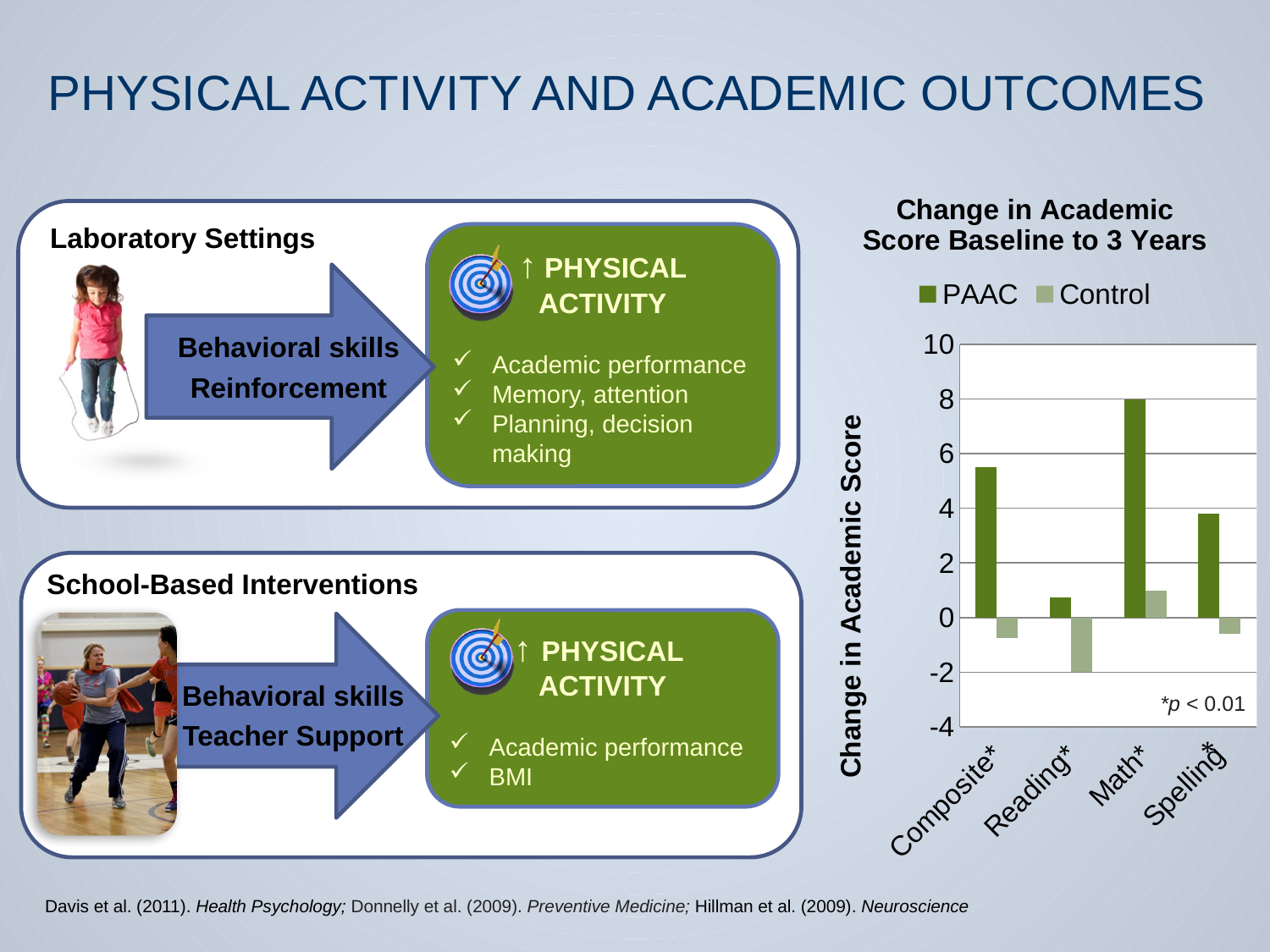
In the "Change in Academic Score Baseline to 3 Years" chart, is the PAAC value larger for Composite* or for Spelling*? Composite* In the "Change in Academic Score Baseline to 3 Years" chart, which category has the highest PAAC value? Math* How many categories are shown on the x axis of the "Change in Academic Score Baseline to 3 Years" chart? 4 In the "Change in Academic Score Baseline to 3 Years" chart, which category has the lowest Control value? Reading* In the "Change in Academic Score Baseline to 3 Years" chart, is the Control value larger for Math* or for Composite*? Math* In the "Change in Academic Score Baseline to 3 Years" chart, is the PAAC value for Math* greater or less than 6? greater In the "Change in Academic Score Baseline to 3 Years" chart, is the PAAC value for Composite* greater or less than 4? greater How many series does the legend of the "Change in Academic Score Baseline to 3 Years" chart list? 2 What kind of chart is shown under the title "Change in Academic Score Baseline to 3 Years"? bar chart In the "Change in Academic Score Baseline to 3 Years" chart, is the PAAC value for Reading* greater or less than 2? less What is the y-axis title of the "Change in Academic Score Baseline to 3 Years" chart? Change in Academic Score